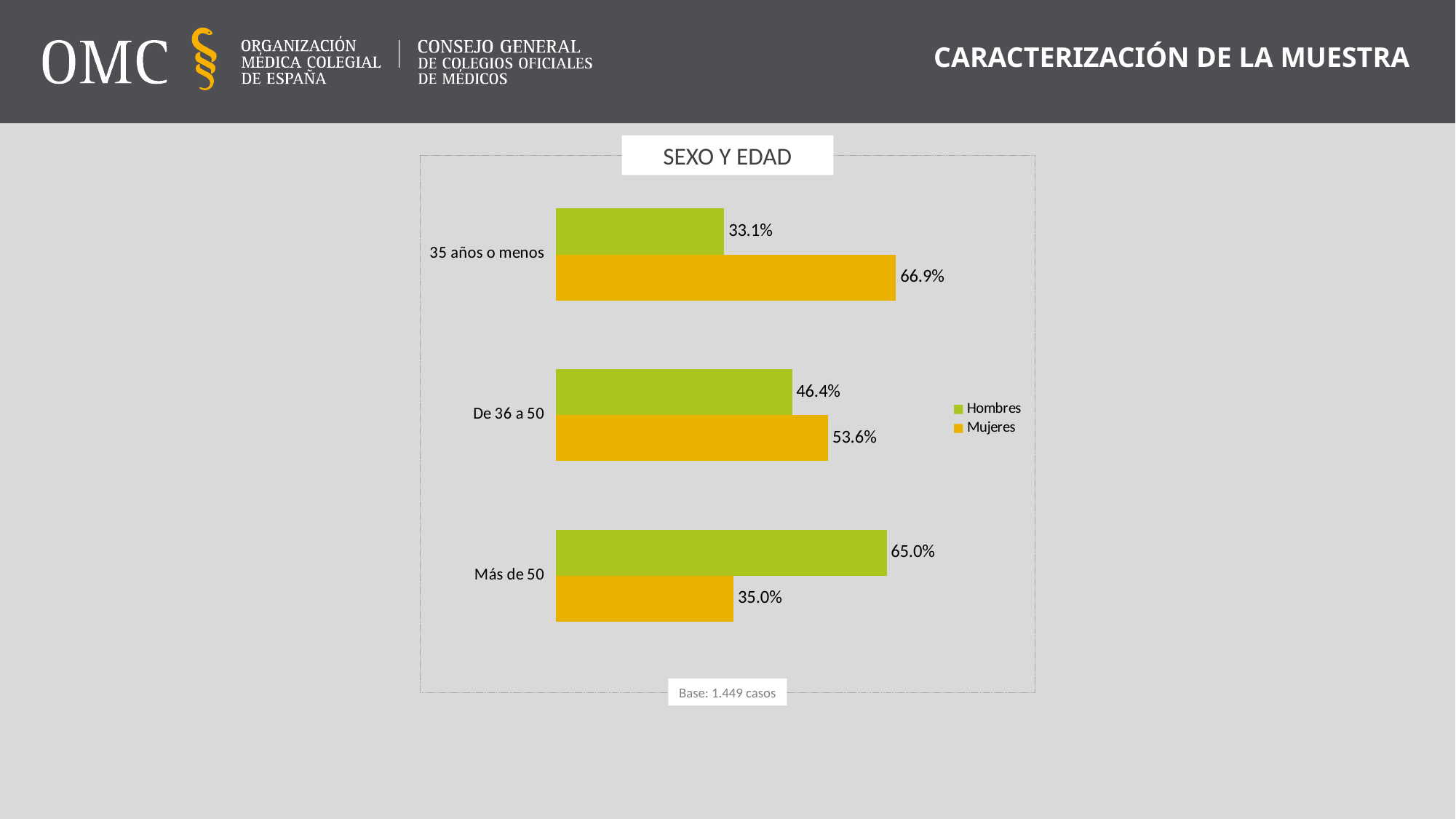
What is the title of the chart? SEXO Y EDAD What is the difference between Mujeres and Hombres in the '35 años o menos' category? 33.8% What is the base (number of cases) stated below the chart? 1.449 casos Which age category has the highest value for Hombres? Más de 50 What is the value for Mujeres in the 'De 36 a 50' category? 53.6% How many age categories are shown in the chart? 3 What is the value for Mujeres in the 'Más de 50' category? 35.0% What kind of chart is shown on the slide? Bar chart In the 'De 36 a 50' category, which is larger, Hombres or Mujeres? Mujeres How many series does the legend list? 2 Which age category has the lowest value for Mujeres? Más de 50 What is the value for Hombres in the '35 años o menos' category? 33.1%